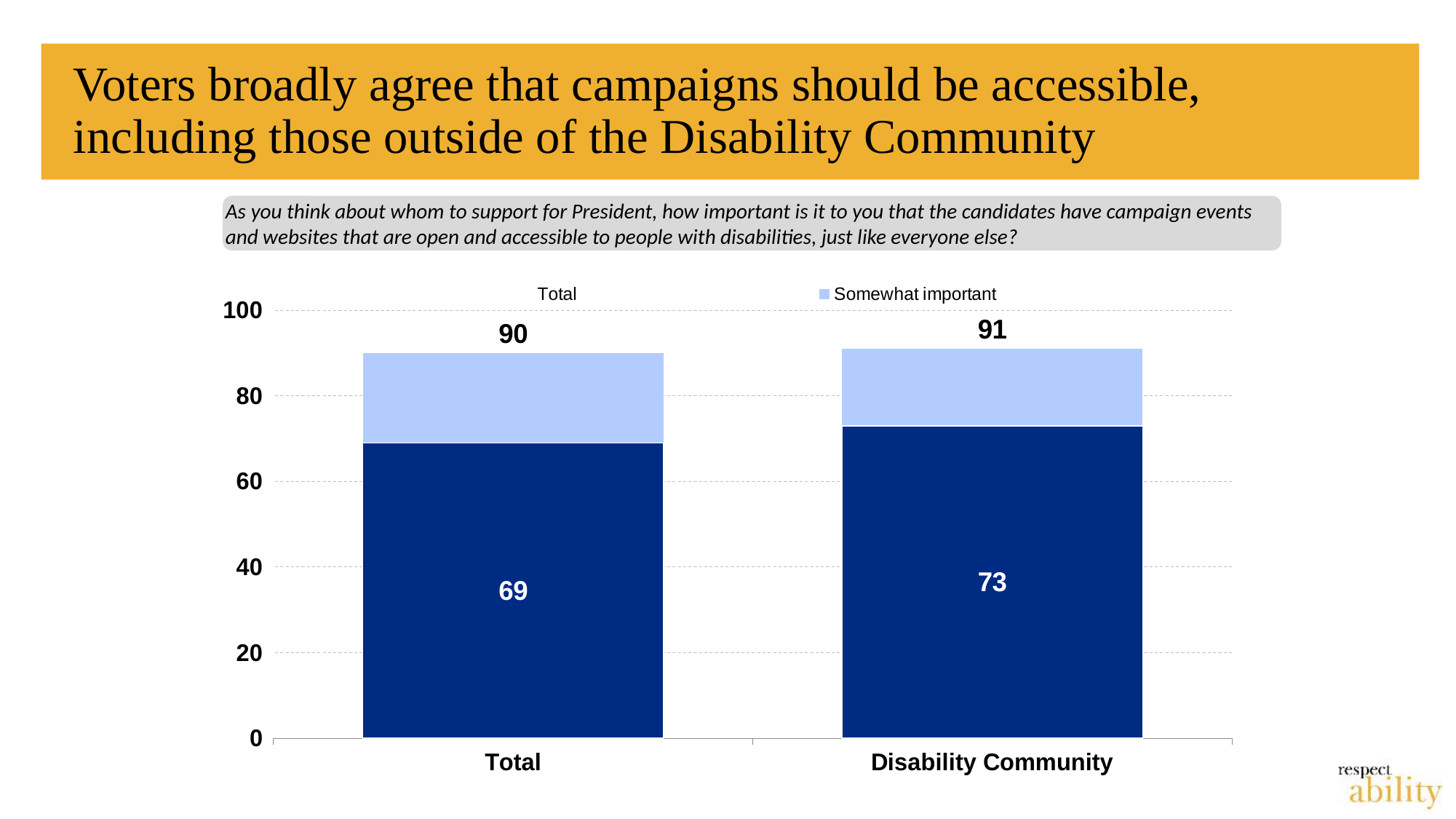
What is the total value printed above the Disability Community bar? 91 Which category has the higher dark blue segment value, Total or Disability Community? Disability Community What is the total value printed above the Total bar? 90 What is the difference between the total values printed above the Disability Community and Total bars? 1 What is the difference between the dark blue segment values for Disability Community and Total? 4 What is the value of the dark blue segment for Disability Community? 73 Which category has the highest total value printed above its bar? Disability Community What type of chart is shown on the slide? stacked bar chart Which legend entry is shown with the light blue marker? Somewhat important What is the value of the dark blue segment for Total? 69 Is the dark blue segment value for Total greater or less than 60? greater How many categories are shown on the x axis of the chart? 2